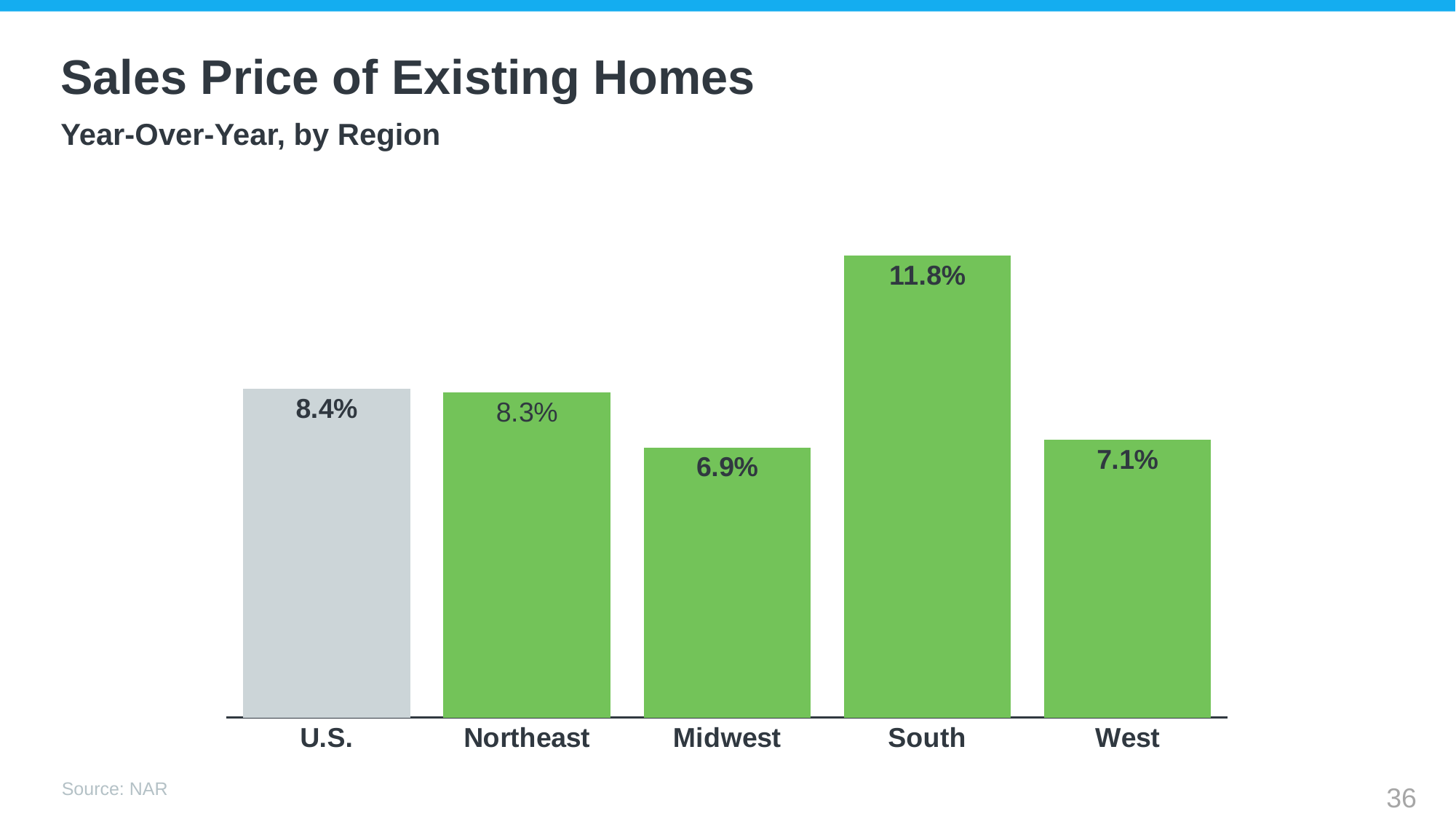
What kind of chart is shown on the slide? Bar chart Which is larger, the value for the West or the value for the Midwest? West How many categories are shown on the chart? 5 What is the value shown for the West? 7.1% Which region has the highest year-over-year sales price change? South What is the value shown for the U.S. bar? 8.4% What is the value shown for the Midwest? 6.9% What is the difference between the South value and the Midwest value? 4.9% Which category has the lowest value on the chart? Midwest What is the year-over-year sales price change for the South? 11.8% Which bar is coloured grey rather than green? U.S. What is the difference between the U.S. value and the Northeast value? 0.1%